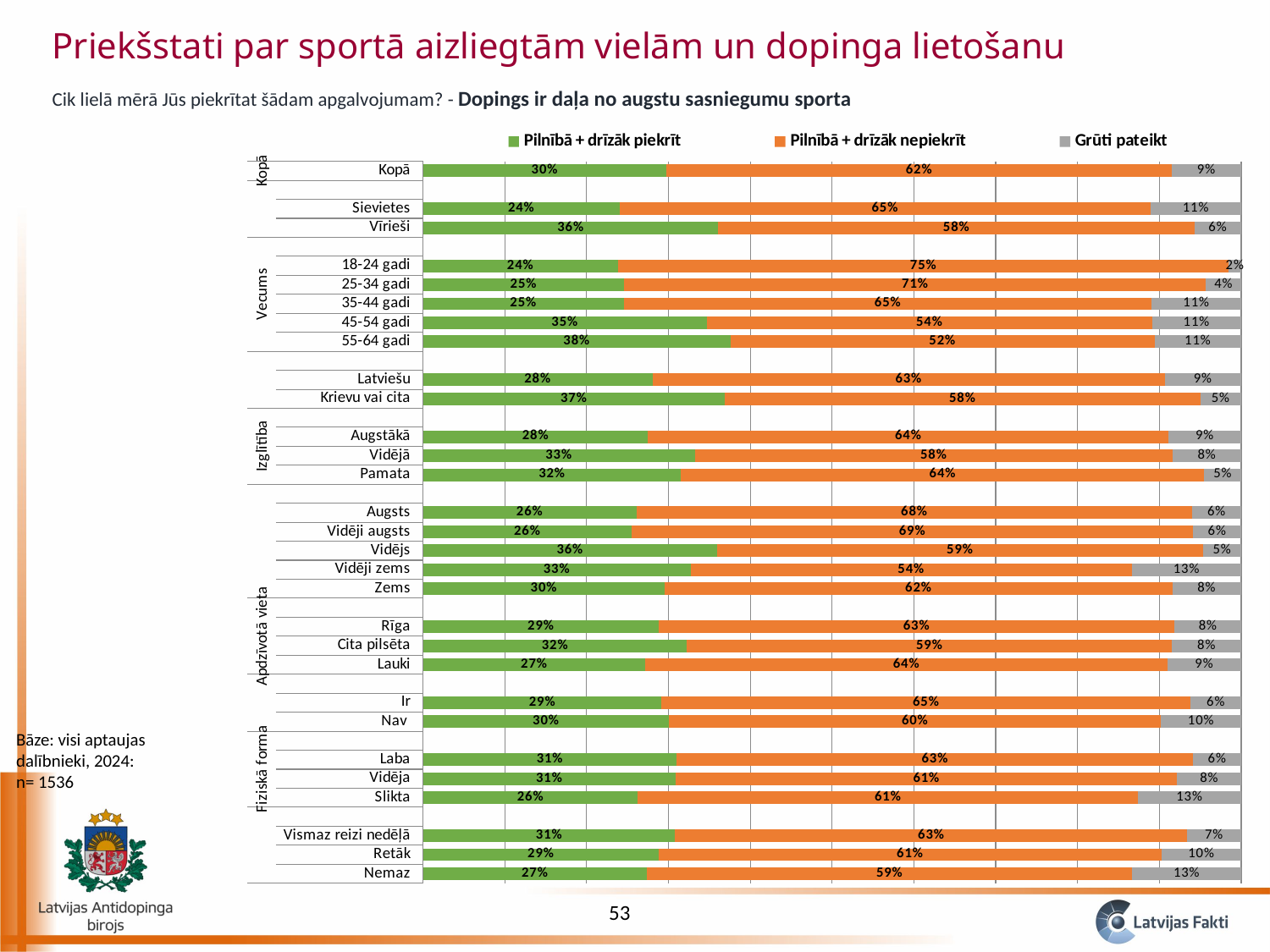
What is the "Grūti pateikt" value for Sievietes? 11% How many categories (bars) are plotted in the chart? 29 What is the "Pilnībā + drīzāk nepiekrīt" value for 18-24 gadi? 75% What is the "Pilnībā + drīzāk piekrīt" value for Kopā? 30% Which category has the lowest "Grūti pateikt" value? 18-24 gadi How many series does the legend list? 3 What kind of chart is shown on the slide? stacked bar chart What is the difference between the "Pilnībā + drīzāk piekrīt" values for Vīrieši and Sievietes? 12% Which category has the highest "Pilnībā + drīzāk piekrīt" value? 55-64 gadi What is the total of the stacked bar for Krievu vai cita? 100% What colour represents the "Grūti pateikt" series? grey Which has a larger "Pilnībā + drīzāk nepiekrīt" value, Augsts or Vidēji zems? Augsts